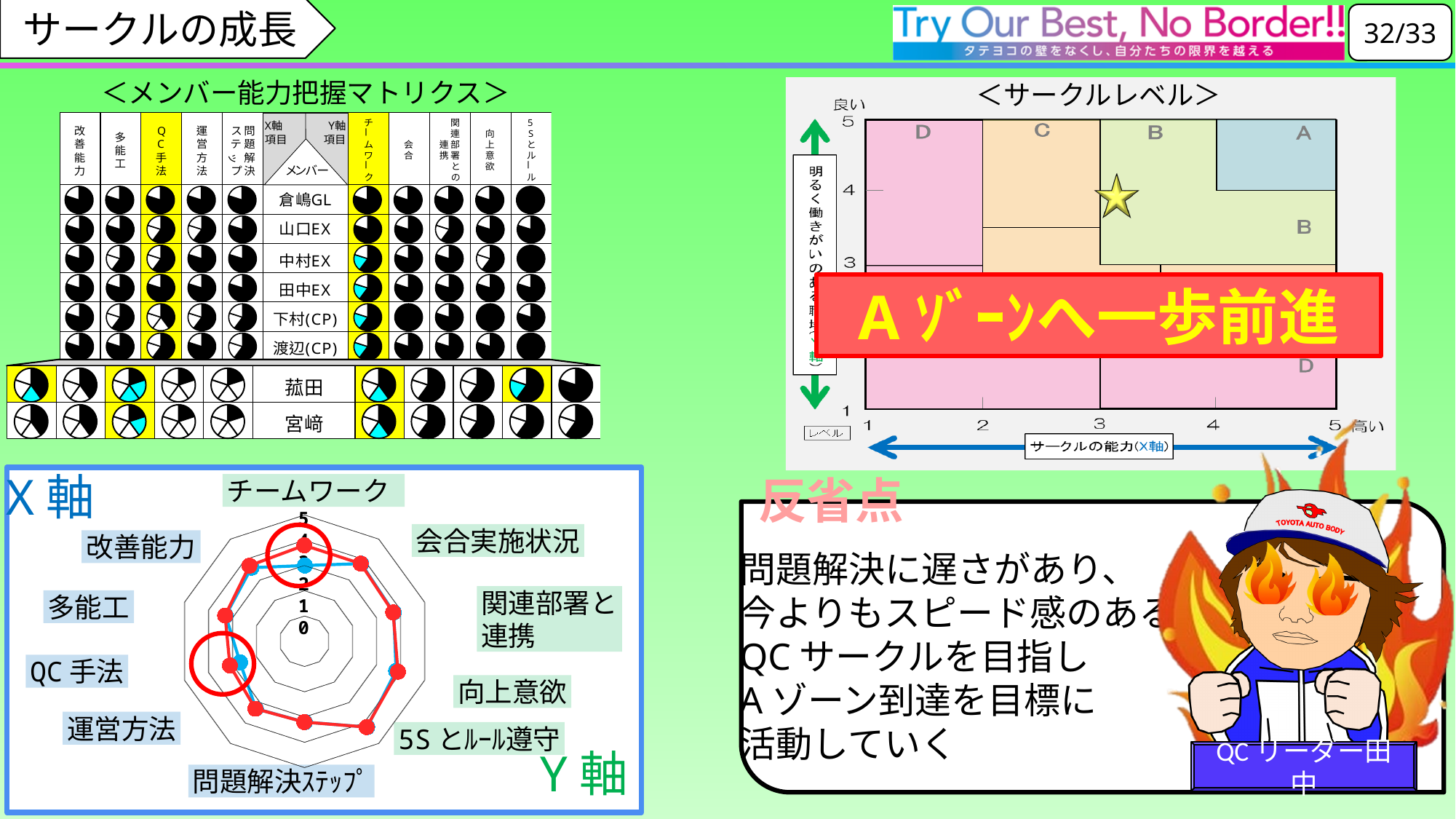
On the radar chart, is the red series value for チームワーク greater or less than 3? greater On the radar chart, what is the maximum value shown on the axis scale? 5 In the サークルレベル chart, is the star marker's x-axis value greater or less than 3? greater How many categories (axes) does the radar chart in the bottom-left panel have? 10 On the radar chart, is the red series value for 会合実施状況 greater or less than 3? greater What is the title of the chart in the top-right panel? サークルレベル How many data series are plotted on the radar chart in the bottom-left panel? 2 What kind of chart is shown in the bottom-left panel labelled X軸 / Y軸? Radar chart In the サークルレベル chart, which zone (A, B, C or D) does the star marker lie in? B On the radar chart, which series has the larger value for チームワーク, the red series or the blue series? red series